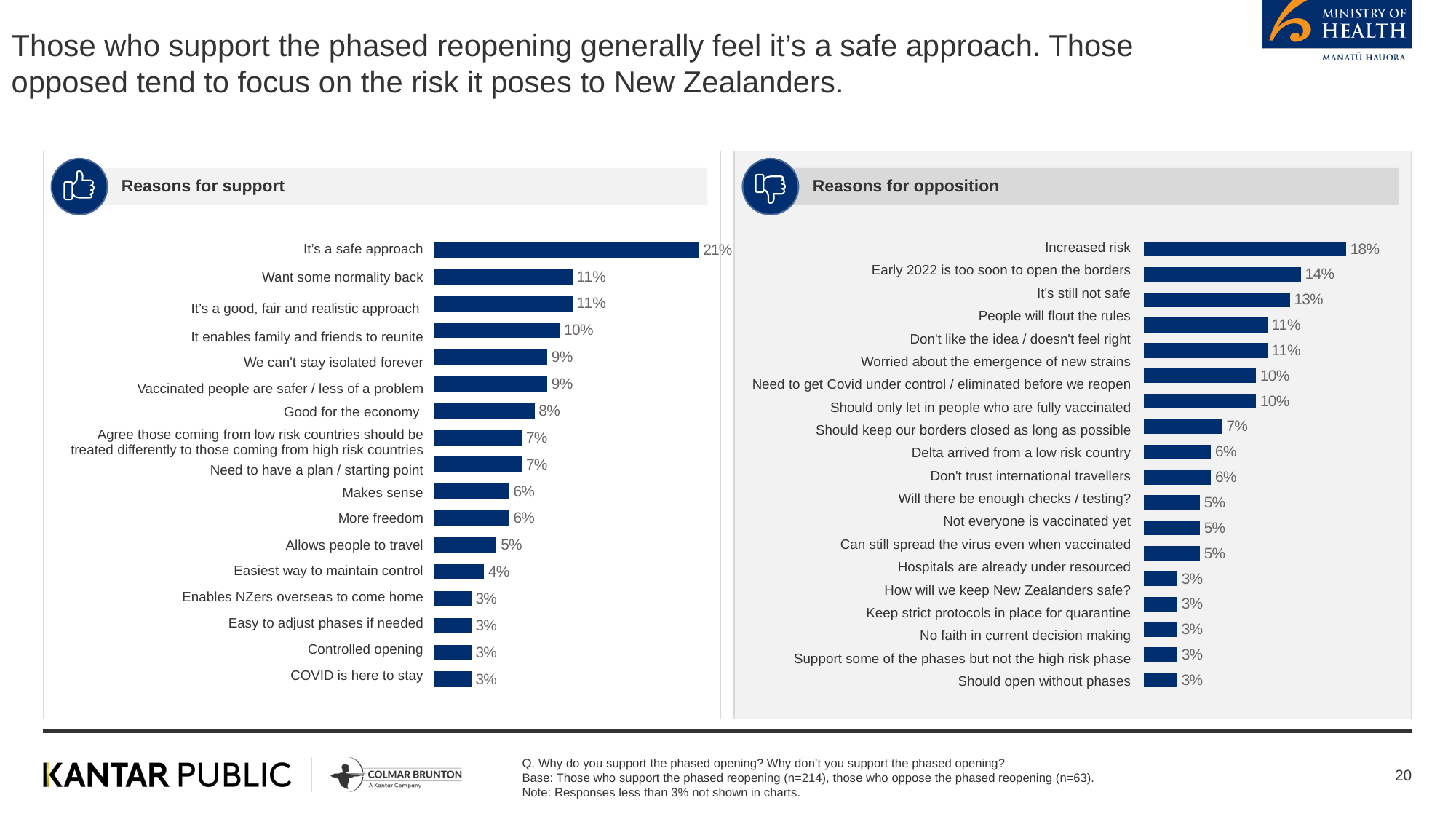
What type of chart is the 'Reasons for support' chart? Bar chart Which chart has the larger top value: 'Reasons for support' or 'Reasons for opposition'? Reasons for support On the 'Reasons for support' chart, what percentage is shown for 'It's a safe approach'? 21% On the 'Reasons for support' chart, which reason has the highest percentage? It's a safe approach On the 'Reasons for opposition' chart, what percentage is shown for 'Increased risk'? 18% How many reasons are listed on the 'Reasons for support' chart? 17 On the 'Reasons for opposition' chart, which reason has the highest percentage? Increased risk On the 'Reasons for support' chart, which is larger: 'It enables family and friends to reunite' or 'Easiest way to maintain control'? It enables family and friends to reunite On the 'Reasons for support' chart, what is the difference between 'It's a safe approach' and 'Want some normality back'? 10 percentage points On the 'Reasons for support' chart, what percentage is shown for 'Allows people to travel'? 5% On the 'Reasons for support' chart, what percentage is shown for 'Good for the economy'? 8% On the 'Reasons for opposition' chart, what percentage is shown for 'Should open without phases'? 3%